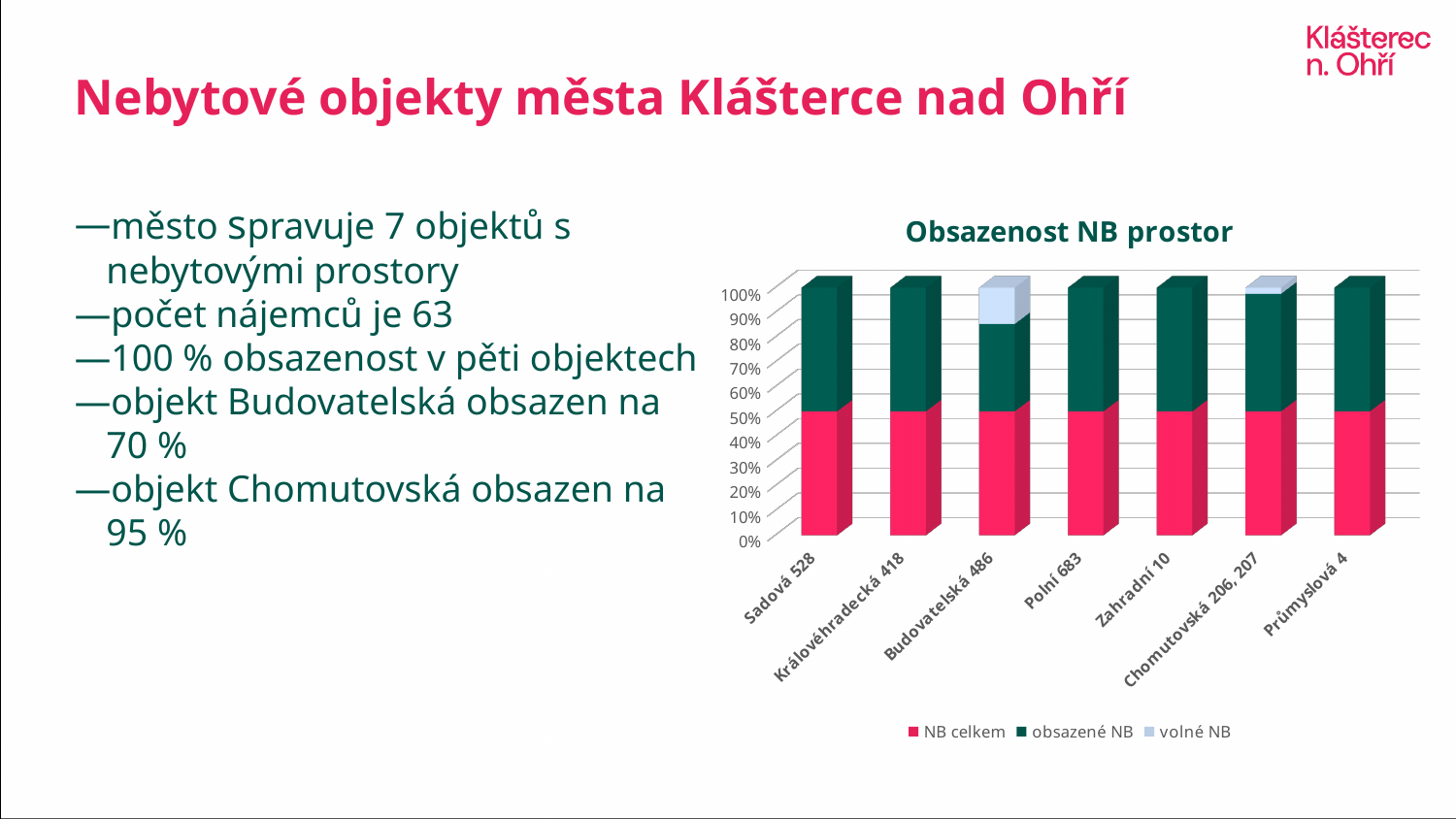
How many categories in the chart show a visible volné NB segment? 2 Is the top of the obsazené NB segment for Budovatelská 486 greater or less than 90%? less Which has a larger volné NB segment, Budovatelská 486 or Chomutovská 206, 207? Budovatelská 486 How many categories (objects) are shown on the x axis of the chart? 7 Which category has the largest volné NB segment in the chart? Budovatelská 486 Which series are listed in the chart legend? NB celkem, obsazené NB, volné NB How many series does the chart legend list? 3 What kind of chart is shown on the slide? stacked bar chart What is the highest value shown on the chart's vertical axis? 100% What is the title of the chart? Obsazenost NB prostor Is the top of the NB celkem segment for Sadová 528 greater or less than 40%? greater Is the top of the obsazené NB segment for Chomutovská 206, 207 greater or less than 90%? greater